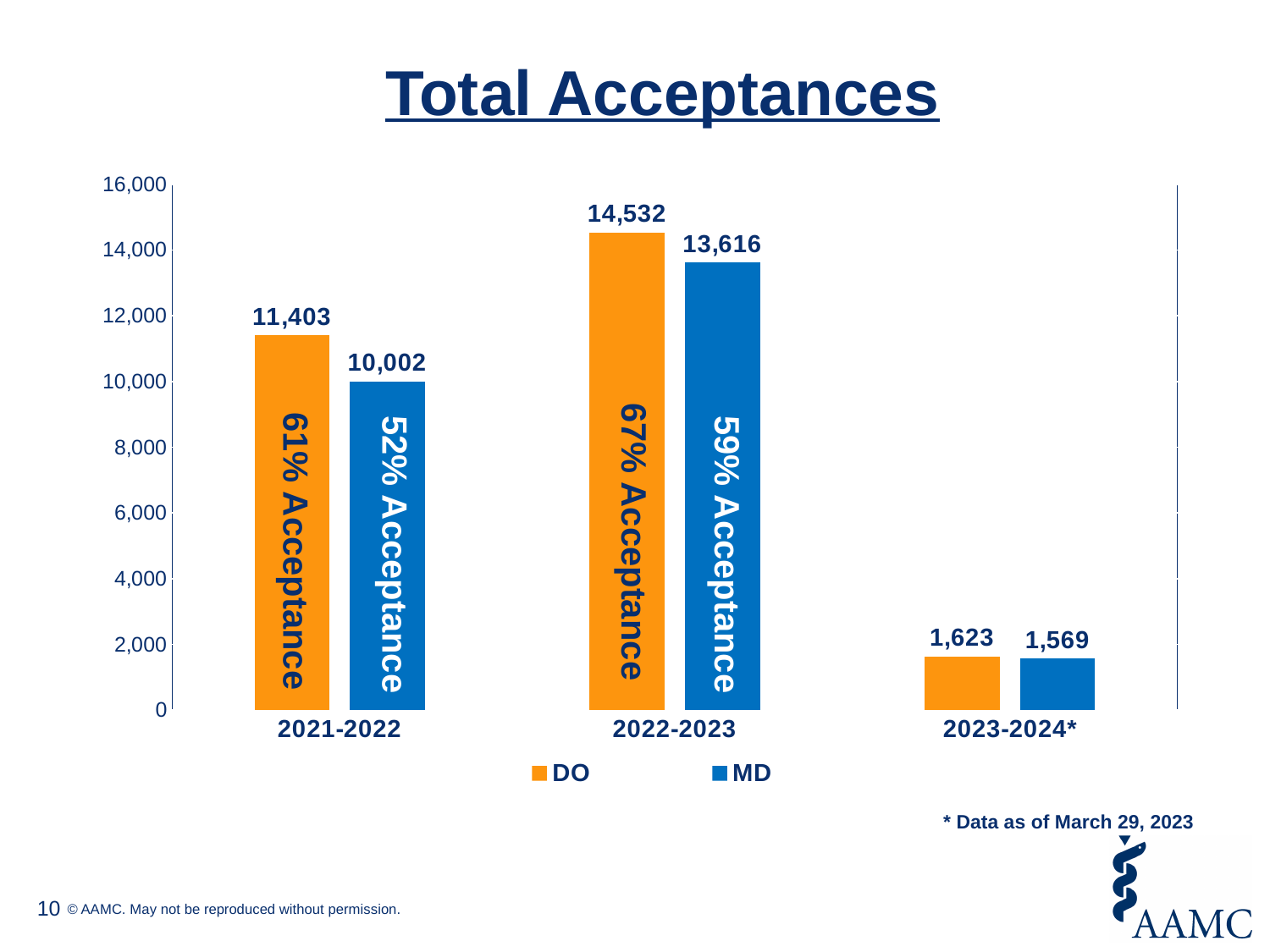
Which year has the lowest MD value? 2023-2024* Which year has the highest DO value? 2022-2023 What kind of chart is shown on the slide? Bar chart What acceptance percentage is printed on the MD bar for 2021-2022? 52% Acceptance How many year categories are shown on the x axis? 3 What is the DO value for 2021-2022? 11,403 How many series does the legend list? 2 What is the difference between the DO and MD values for 2022-2023? 916 What is the difference between the DO values for 2021-2022 and 2022-2023? 3,129 What is the MD value for 2022-2023? 13,616 Which is larger in 2021-2022, the DO value or the MD value? DO What is the MD value for 2023-2024*? 1,569